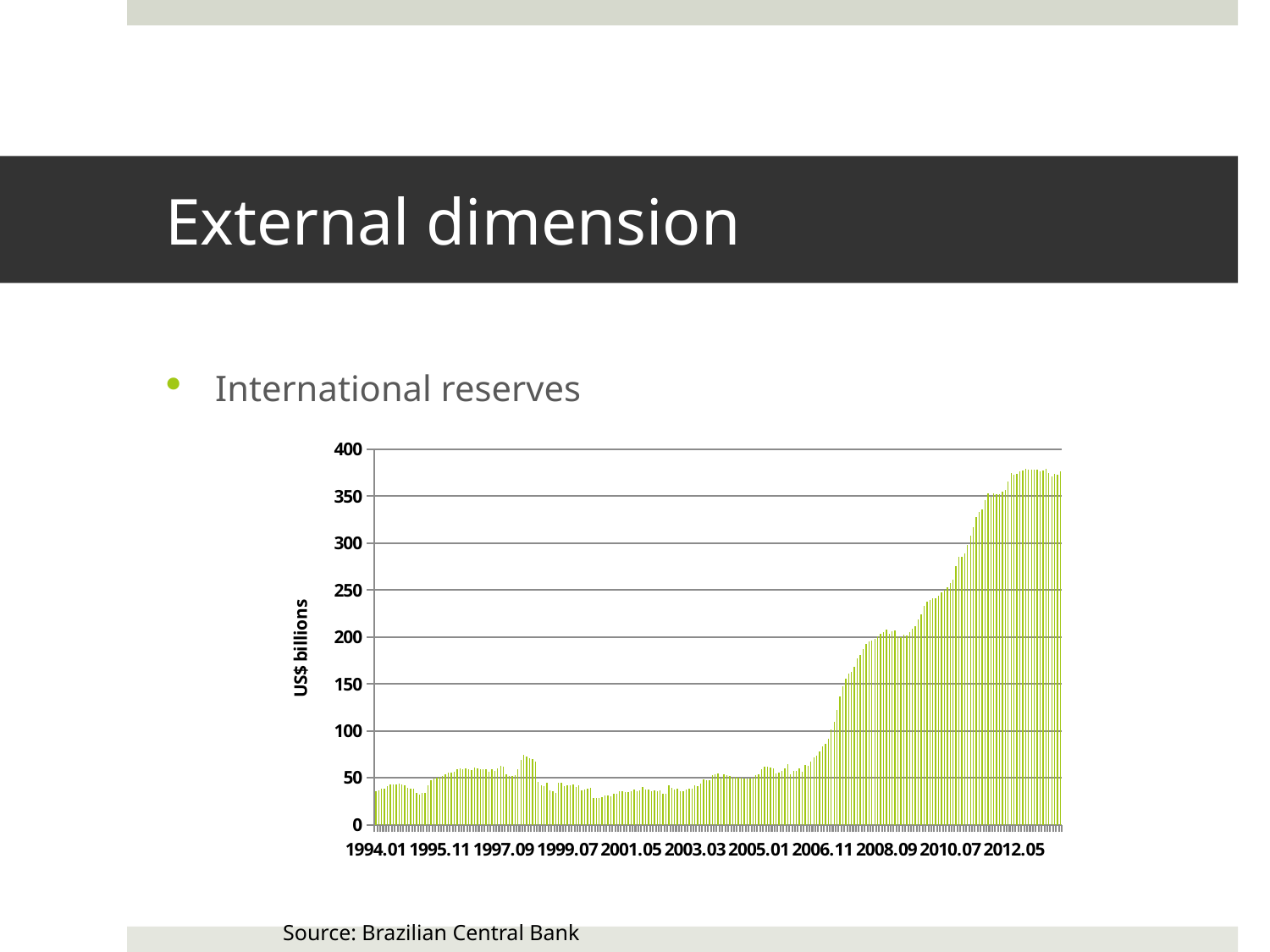
What kind of chart is shown on the slide? bar chart How many date labels are shown on the x axis? 11 Which has the larger value, 1994.01 or 2012.05? 2012.05 Is the value for 2003.03 greater or less than 50? less Do the values generally rise or fall from 2006.11 to 2008.09? rise What is the source cited for the chart? Brazilian Central Bank Is the value for 2012.05 greater or less than 350? greater Is the value for 2010.07 greater or less than 200? greater What is the y-axis title of the chart? US$ billions